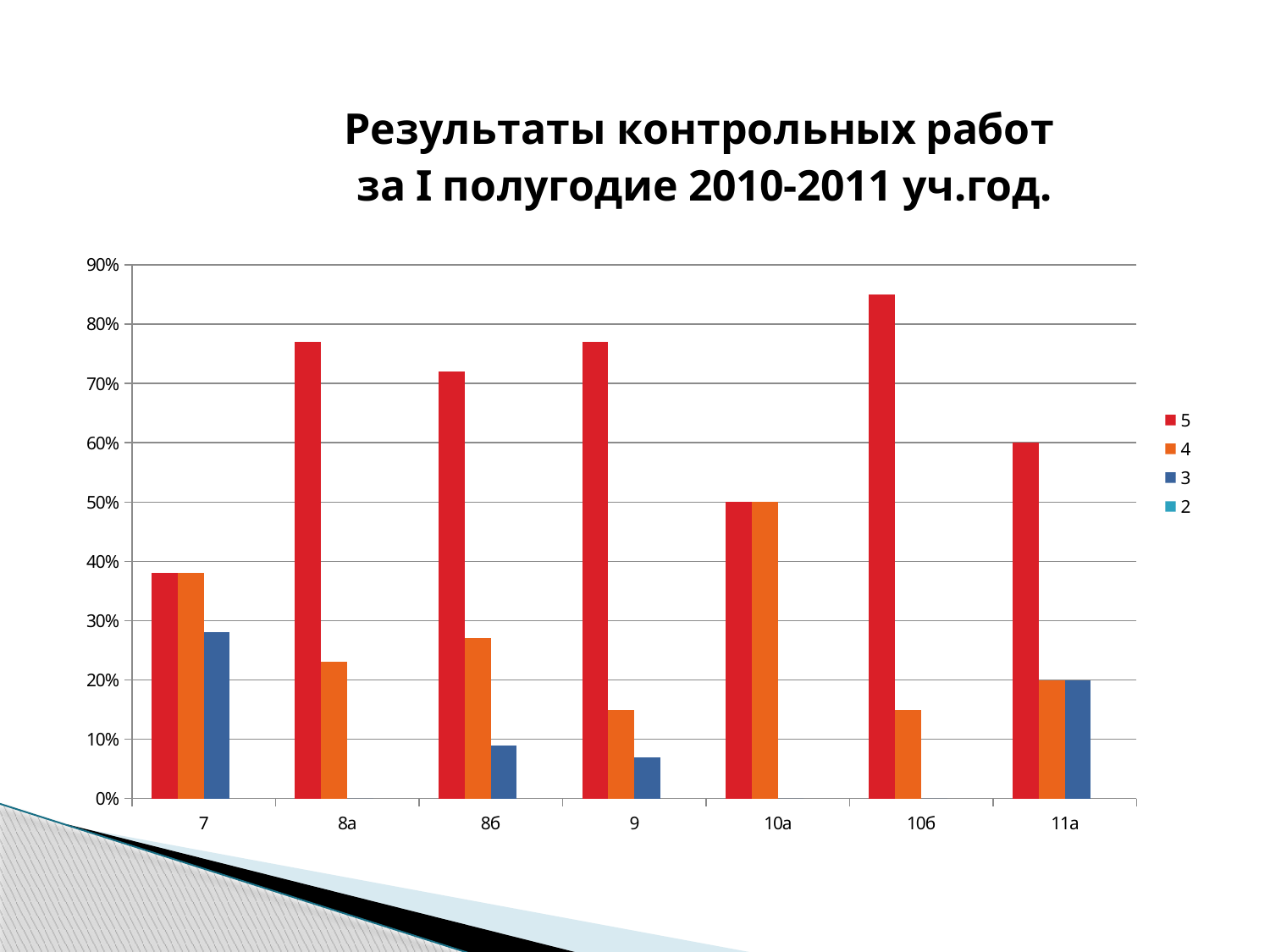
How many categories are shown on the x axis? 7 Is the value of series "5" for category 10б greater or less than 80%? greater Which category has the lowest value for series "5"? 7 What is the value of series "3" for category 11а? 20% What is the difference between series "5" and series "4" for category 11а? 40% What is the value of series "4" for category 10а? 50% Which category has the highest value for series "5"? 10б What is the value of series "5" for category 11а? 60% How many series does the legend list? 4 What type of chart is shown on the slide? bar chart Which is larger: series "3" for category 7 or series "3" for category 11а? category 7 What is the value of series "5" for category 10а? 50%